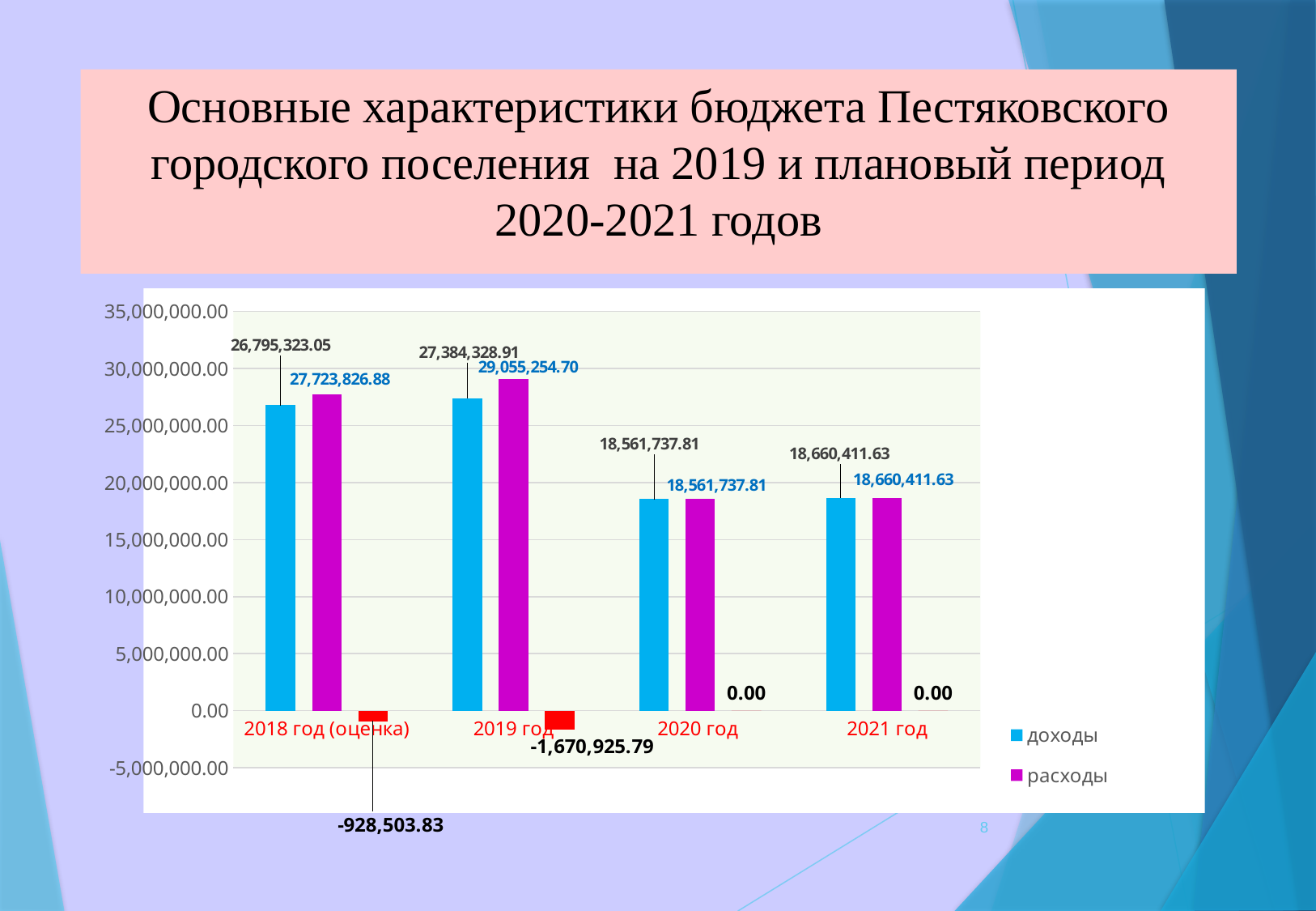
Which year has the lowest value of доходы? 2020 год What is the value of the red bar for 2019 год? -1,670,925.79 What type of chart is shown on the slide? bar chart How many year categories are shown on the x axis? 4 What is the value of доходы for 2019 год? 27,384,328.91 Which is larger for 2018 год (оценка): доходы or расходы? расходы What is the value of расходы for 2018 год (оценка)? 27,723,826.88 How many series does the legend list? 2 What is the value of расходы for 2021 год? 18,660,411.63 Is the value of доходы for 2020 год greater or less than 20,000,000.00? less What is the difference between расходы and доходы for 2019 год? 1,670,925.79 Which year has the highest value of расходы? 2019 год